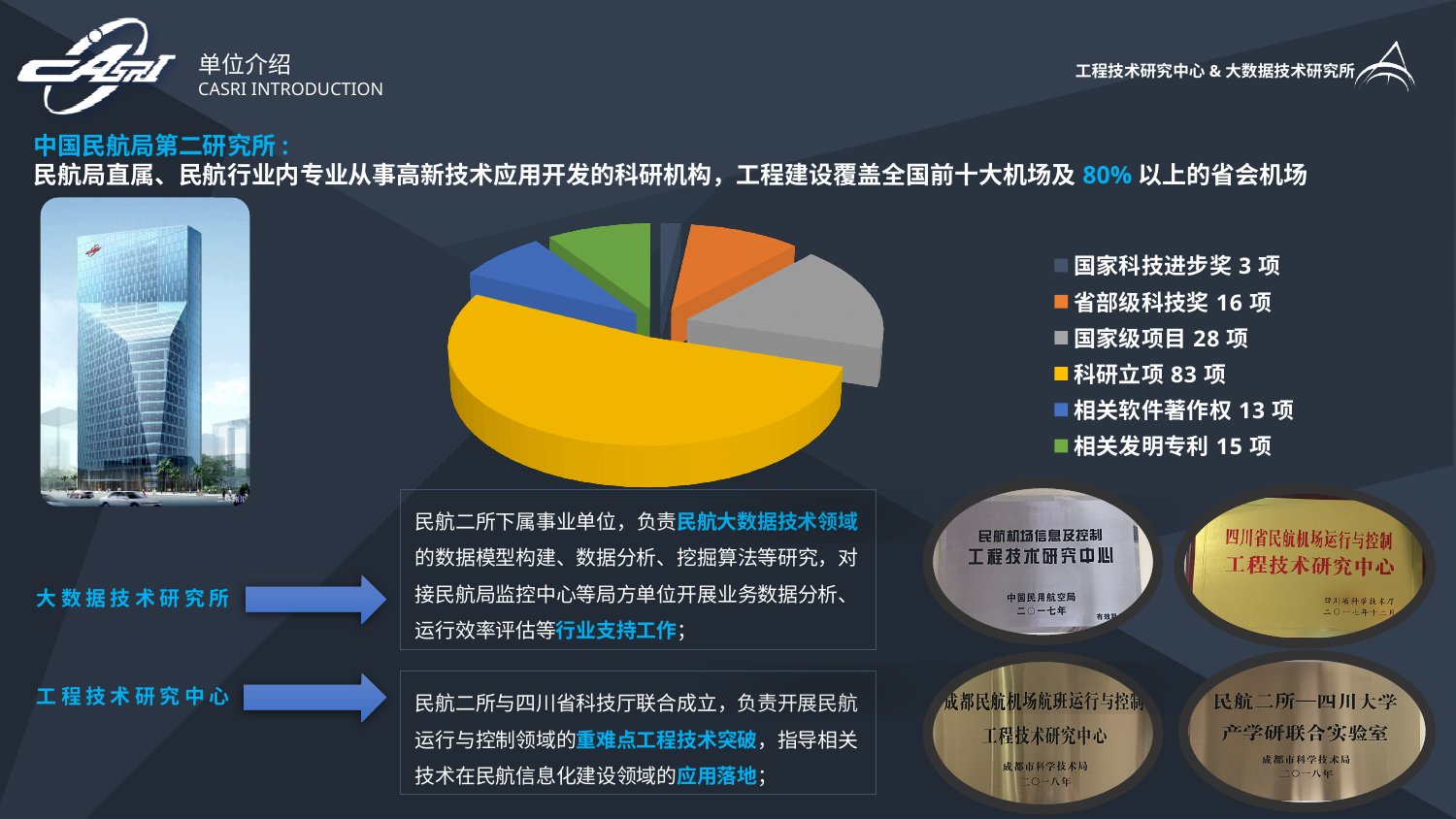
How many categories does the pie chart's legend list? 6 What is the value shown for 省部级科技奖 in the pie chart legend? 16 项 What is the value shown for 国家级项目 in the pie chart legend? 28 项 Which is larger, the value for 相关发明专利 or the value for 相关软件著作权? 相关发明专利 What colour is the slice for 省部级科技奖 in the pie chart? orange What colour is the slice for 科研立项 in the pie chart? yellow What kind of chart is shown on the slide? pie chart What is the value shown for 相关软件著作权 in the pie chart legend? 13 项 What is the difference between the values for 科研立项 and 国家级项目? 55 项 Which category has the largest slice in the pie chart? 科研立项 Which category has the smallest slice in the pie chart? 国家科技进步奖 What is the value shown for 科研立项 in the pie chart legend? 83 项